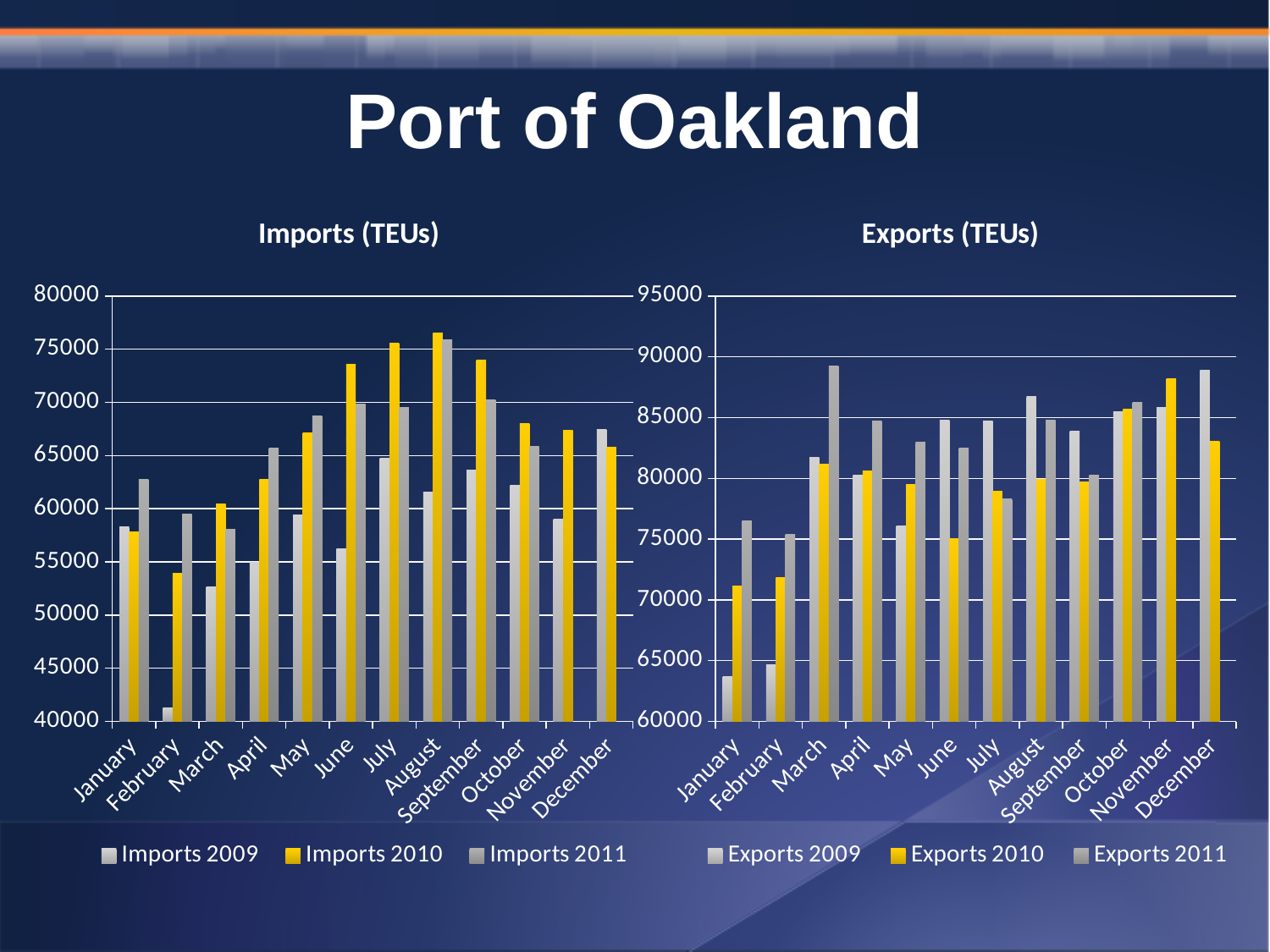
In the Imports (TEUs) chart, which is larger in June: Imports 2009 or Imports 2010? Imports 2010 In the Exports (TEUs) chart, is the value for Exports 2011 in March greater or less than 85000? greater In the Exports (TEUs) chart, which month has the highest value for Exports 2010? November How many months are shown on the x axis of the Imports (TEUs) chart? 12 In the Imports (TEUs) chart, is the value for Imports 2010 in August greater or less than 75000? greater How many series does the legend of the Exports (TEUs) chart list? 3 In the Exports (TEUs) chart, which is larger in March: Exports 2010 or Exports 2011? Exports 2011 In the Imports (TEUs) chart, which month has the lowest value for Imports 2009? February In the Imports (TEUs) chart, do the Imports 2010 values rise or fall from January to August? rise In the Imports (TEUs) chart, which month has the lowest value for Imports 2010? February In the Imports (TEUs) chart, is the value for Imports 2009 in February greater or less than 45000? less What kind of chart is the Imports (TEUs) chart? bar chart